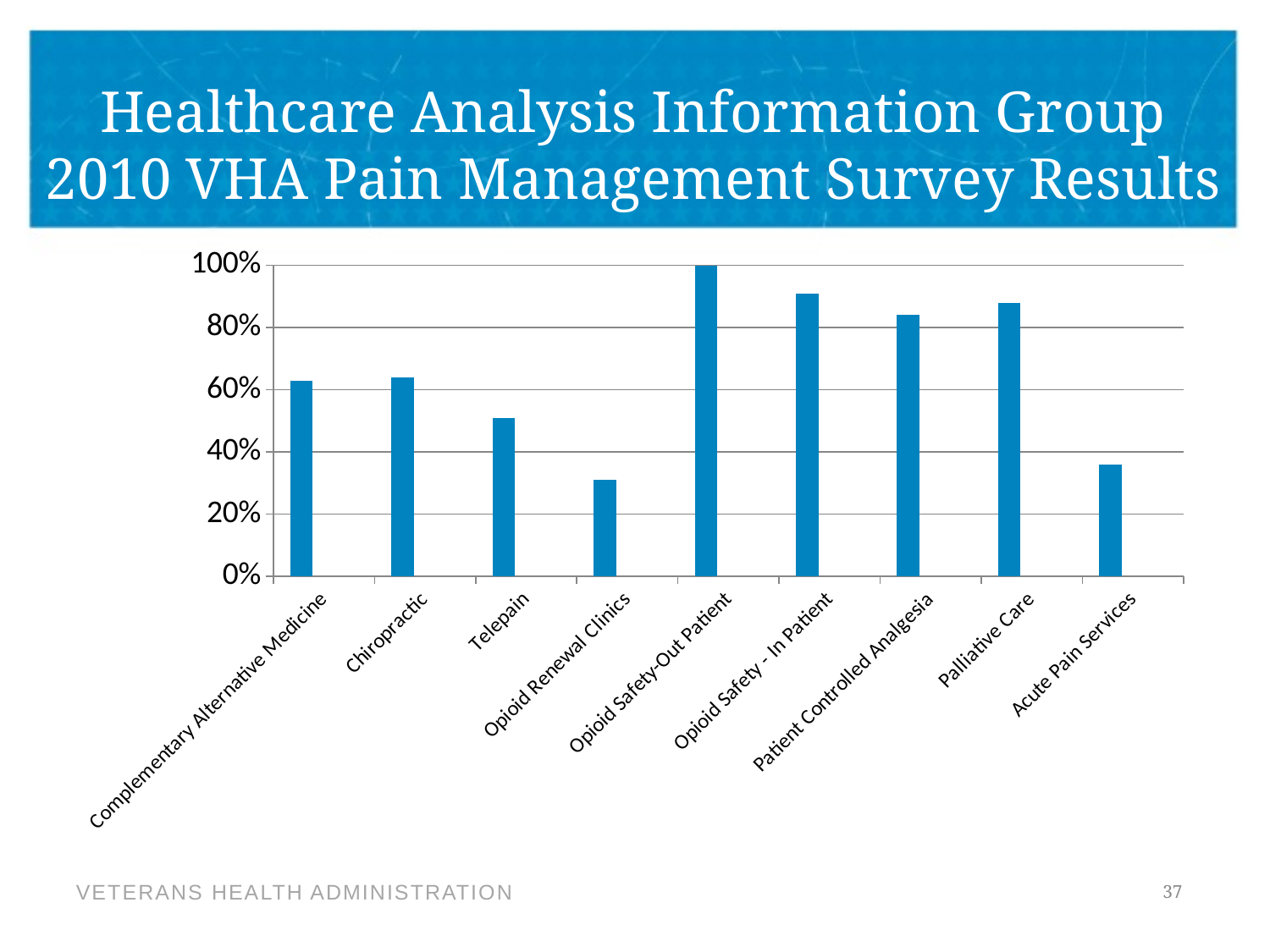
What is the value for Opioid Safety-Out Patient? 100% What is the title of the slide containing the chart? Healthcare Analysis Information Group 2010 VHA Pain Management Survey Results Which is larger, the value for Opioid Safety - In Patient or the value for Patient Controlled Analgesia? Opioid Safety - In Patient Is the value for Opioid Renewal Clinics greater or less than 40%? less Which category has the lowest value on the chart? Opioid Renewal Clinics Which is larger, the value for Telepain or the value for Acute Pain Services? Telepain Is the value for Telepain greater or less than 40%? greater Which category has the highest value on the chart? Opioid Safety-Out Patient Is the value for Acute Pain Services greater or less than 40%? less What kind of chart is shown on the slide? Bar chart How many categories are plotted on the chart? 9